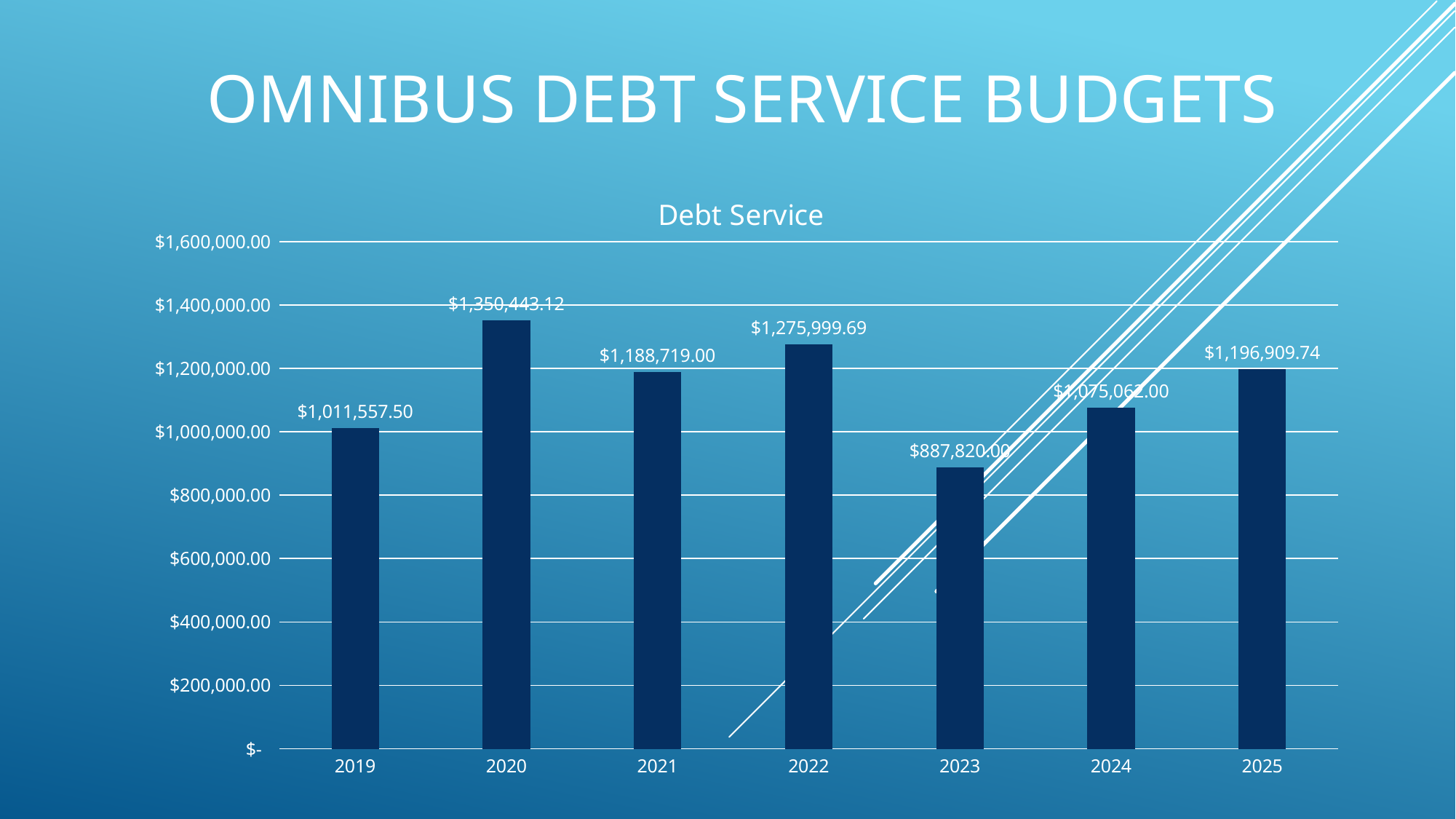
Is the Debt Service value for 2023 greater or less than $1,000,000.00? less What is the Debt Service value for 2022? $1,275,999.69 What is the Debt Service value for 2025? $1,196,909.74 Which year has the highest Debt Service value? 2020 Which year has the lowest Debt Service value? 2023 What type of chart is shown on the slide? Bar chart What is the Debt Service value for 2020? $1,350,443.12 How many years are shown on the x axis of the chart? 7 What is the title of the chart? Debt Service Which year has the larger Debt Service value, 2021 or 2022? 2022 Is the Debt Service value for 2024 greater or less than $1,000,000.00? greater What is the Debt Service value for 2019? $1,011,557.50